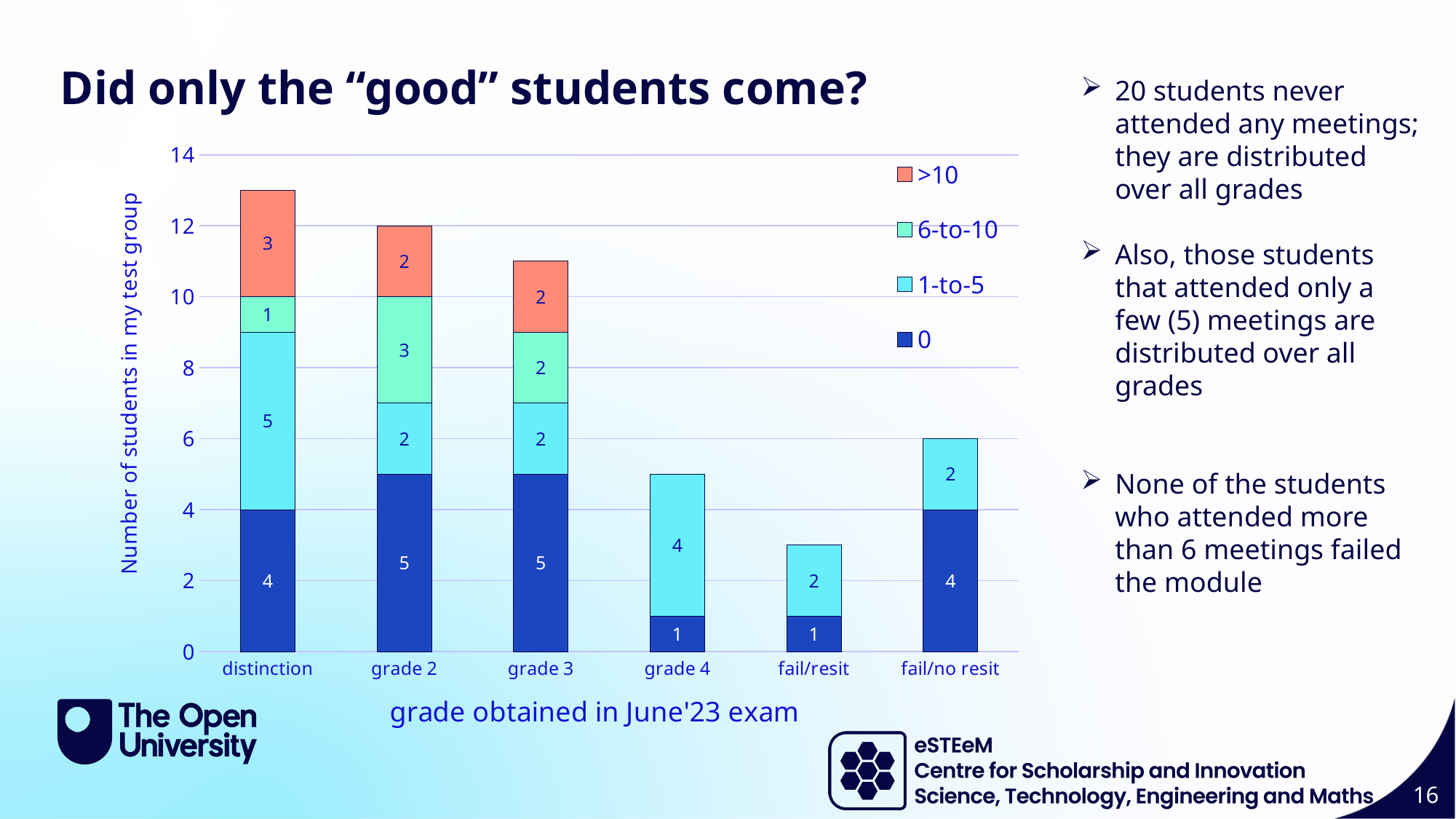
What kind of chart is shown on the slide? stacked bar chart How many grade categories are shown on the x axis? 6 What is the difference between the '6-to-10' values for grade 2 and grade 3? 1 Which category has the highest total bar? distinction What is the total of the stacked bar for fail/resit? 3 How many series does the legend list? 4 Which category has the lowest total bar? fail/resit What is the total of the stacked bar for distinction? 13 Which is larger: the '0' value for grade 3 or the '0' value for fail/no resit? grade 3 What is the value of the '>10' series for grade 2? 2 What is the value of the '1-to-5' series for grade 4? 4 What is the value of the '0' series for the distinction category? 4